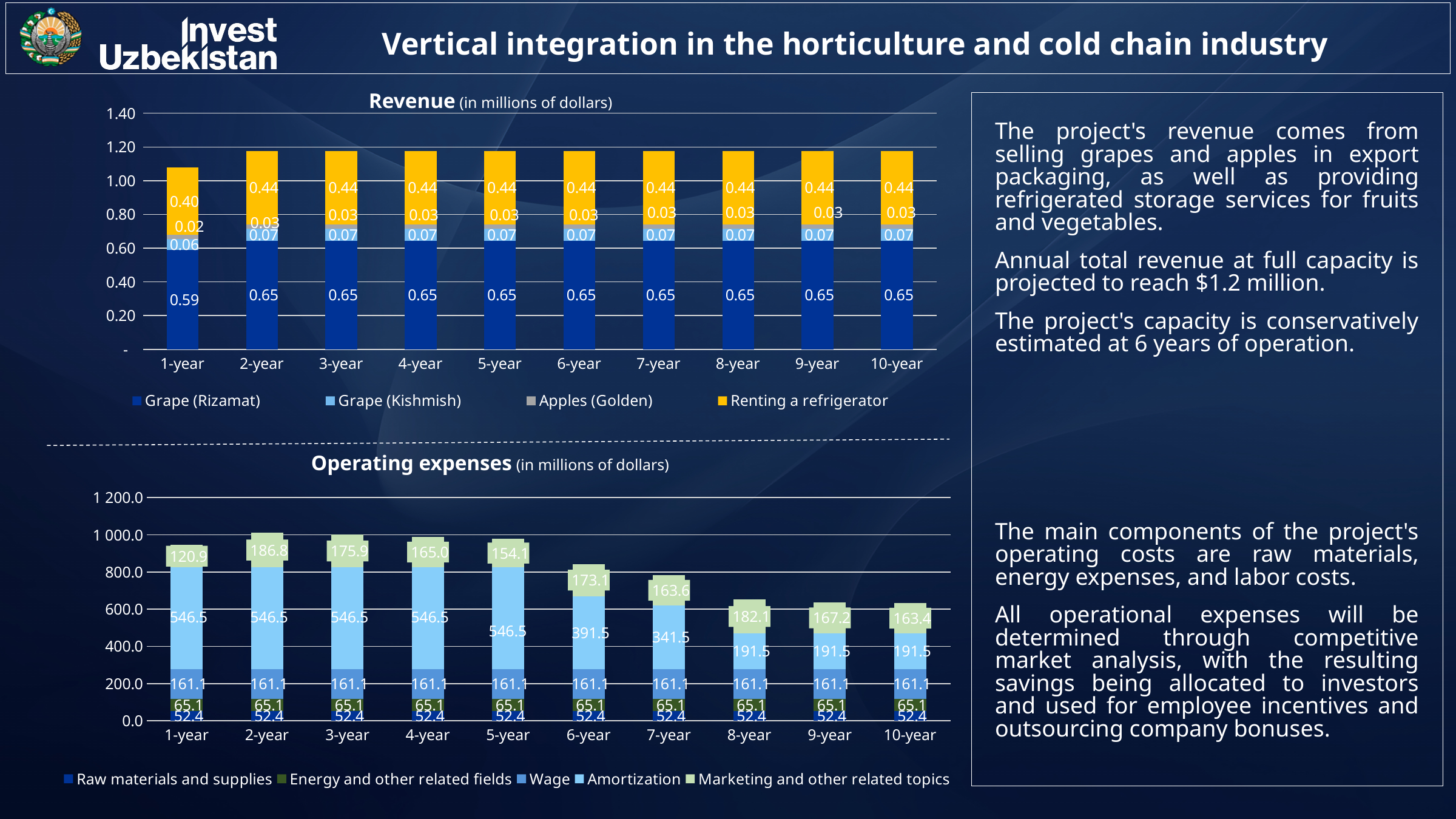
On the Operating expenses chart, which year has the highest Marketing and other related topics value? 2-year On the Operating expenses chart, what is the value for Amortization in 6-year? 391.5 What kind of chart is the Operating expenses chart? Stacked bar chart On the Revenue chart, what is the value for Renting a refrigerator in 5-year? 0.44 On the Operating expenses chart, what is the value for Marketing and other related topics in 2-year? 186.8 On the Revenue chart, what is the difference between Grape (Rizamat) in 2-year and in 1-year? 0.06 On the Operating expenses chart, what is the total of the stacked bar for 10-year? 633.5 On the Revenue chart, what is the total of the stacked bar for 2-year? 1.19 On the Operating expenses chart, how many categories are shown on the x axis? 10 On the Revenue chart, what is the value for Grape (Rizamat) in 1-year? 0.59 On the Operating expenses chart, is Amortization larger in 7-year or in 8-year? 7-year On the Revenue chart, how many series does the legend list? 4